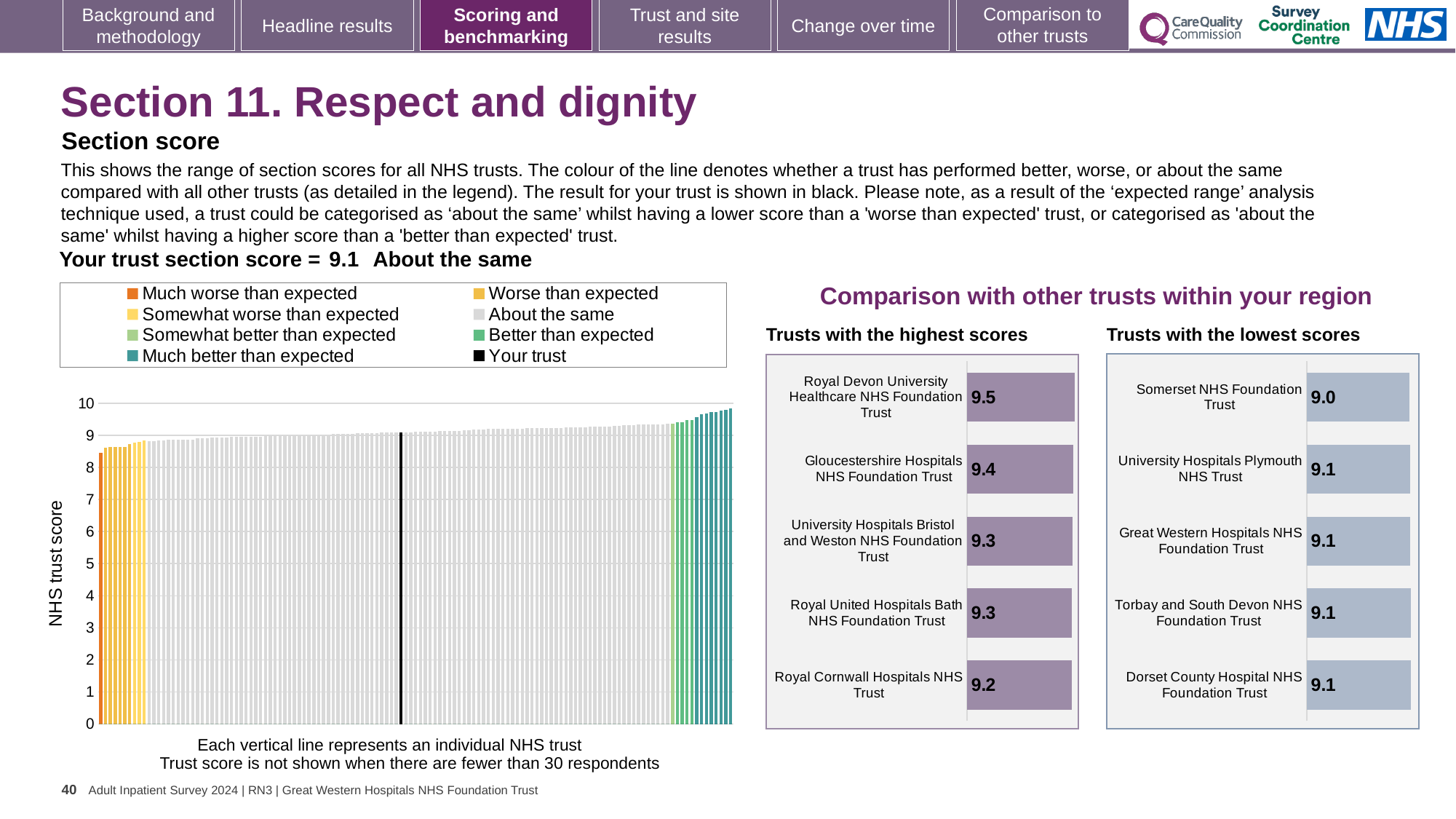
In the 'Trusts with the lowest scores' chart, what is the score for Dorset County Hospital NHS Foundation Trust? 9.1 In the 'Trusts with the highest scores' chart, which has the higher score: Gloucestershire Hospitals NHS Foundation Trust or Royal Cornwall Hospitals NHS Trust? Gloucestershire Hospitals NHS Foundation Trust In the 'Trusts with the highest scores' chart, what is the score for Royal Devon University Healthcare NHS Foundation Trust? 9.5 In the 'Trusts with the highest scores' chart, what is the difference between the scores of Royal Devon University Healthcare NHS Foundation Trust and Royal Cornwall Hospitals NHS Trust? 0.3 In the 'Trusts with the lowest scores' chart, which trust has the lowest score? Somerset NHS Foundation Trust In the large 'NHS trust score' chart, is the value of the lowest-scoring trust (leftmost bar) greater or less than 9? less In the 'Trusts with the highest scores' chart, which trust has the highest score? Royal Devon University Healthcare NHS Foundation Trust In the 'Trusts with the lowest scores' chart, what is the score for Somerset NHS Foundation Trust? 9.0 What kind of chart is the large 'NHS trust score' chart on the left of the slide? Bar chart How many entries does the legend of the large 'NHS trust score' chart list? 8 In the legend of the large 'NHS trust score' chart, what colour represents 'Your trust'? Black How many trusts are shown in the 'Trusts with the highest scores' chart? 5